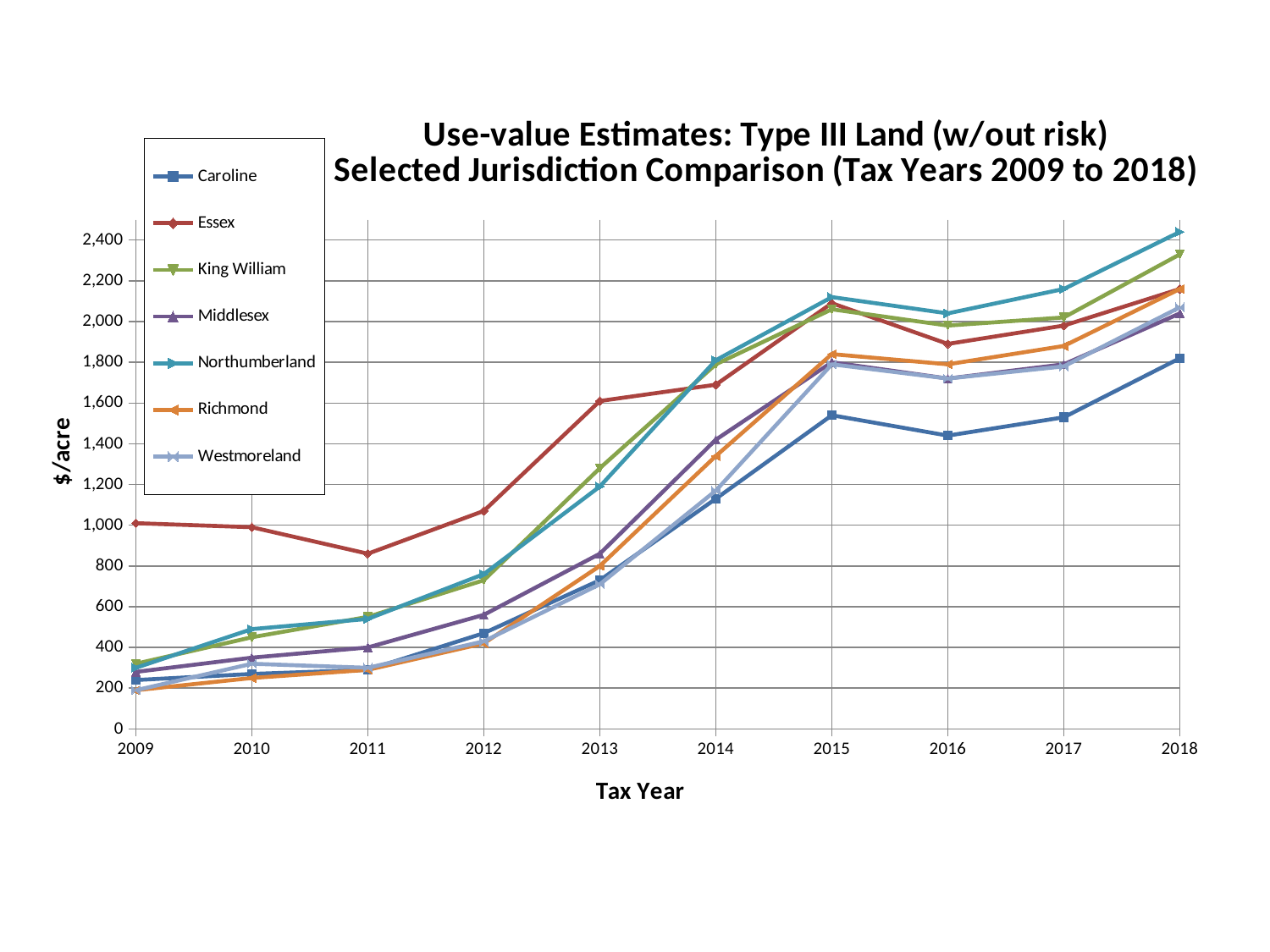
Is the value for Northumberland in 2018 greater or less than 2,200? greater Which jurisdiction has the highest value in 2009? Essex How many tax years are plotted along the x axis? 10 Which jurisdiction has the highest value in 2018? Northumberland In 2013, which is larger: the value for Essex or the value for Caroline? Essex Is the value for Caroline in 2015 greater or less than 1,600? less Is the value for Essex in 2011 greater or less than 1,000? less How many jurisdictions does the legend list? 7 What is the label on the y axis? $/acre Does the value for Essex rise or fall from 2009 to 2011? fall What kind of chart is shown on the slide? line chart Which jurisdiction has the lowest value in 2018? Caroline